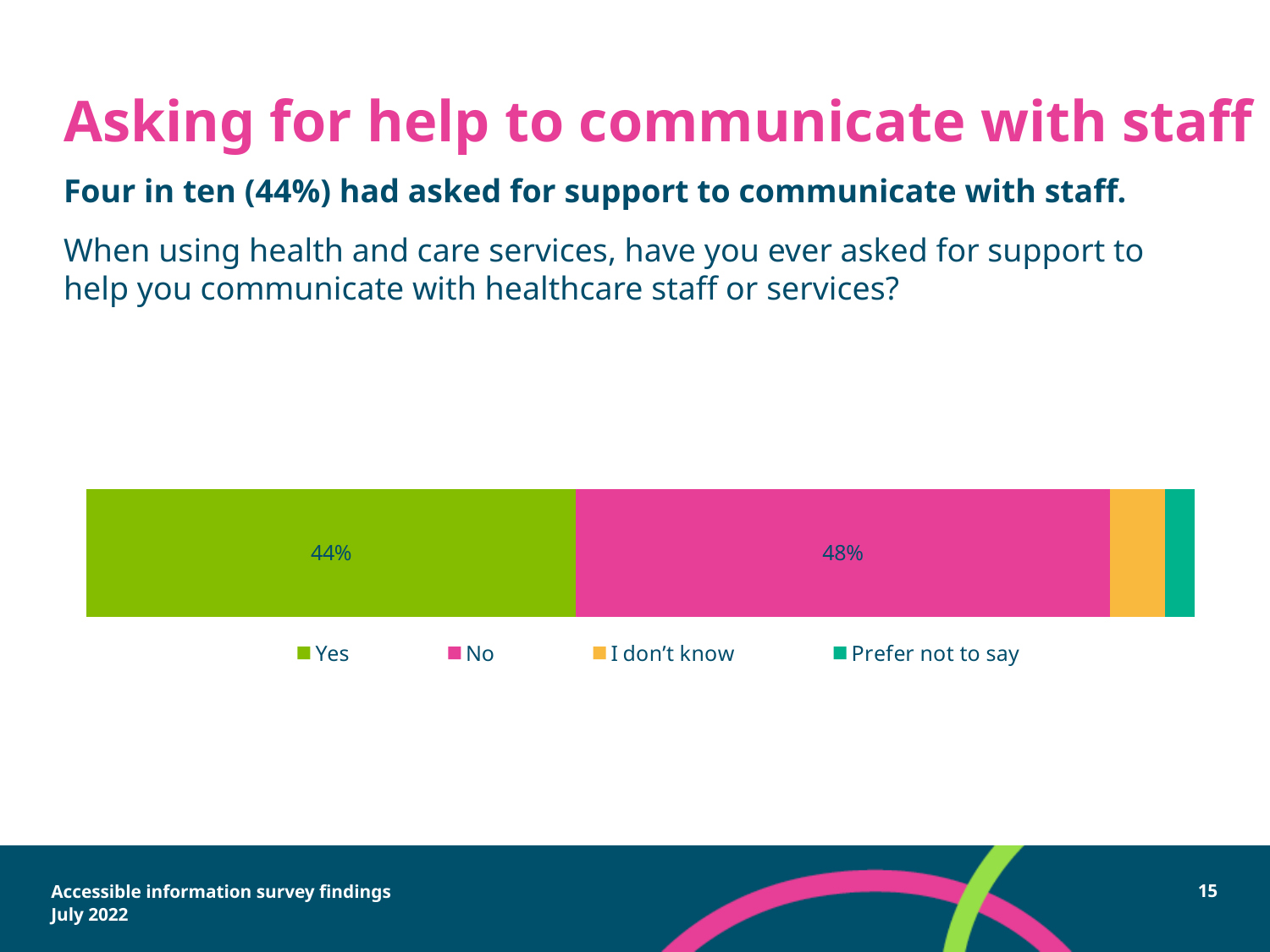
How many response categories does the legend list? 4 Which of the two smallest segments is larger, "I don't know" or "Prefer not to say"? I don't know Which response has the largest share in the bar? No What is the difference between the "No" share and the "Yes" share? 4 percentage points Which response category is shown in pink in the chart? No Which response category has the smallest share in the bar? Prefer not to say Which response category is shown in green in the chart? Yes What percentage of respondents answered "Yes" to having asked for support to communicate with staff? 44% Which is larger, the share for "Yes" or the share for "No"? No What kind of chart is shown on the slide? Stacked bar chart What percentage of respondents answered "No"? 48%